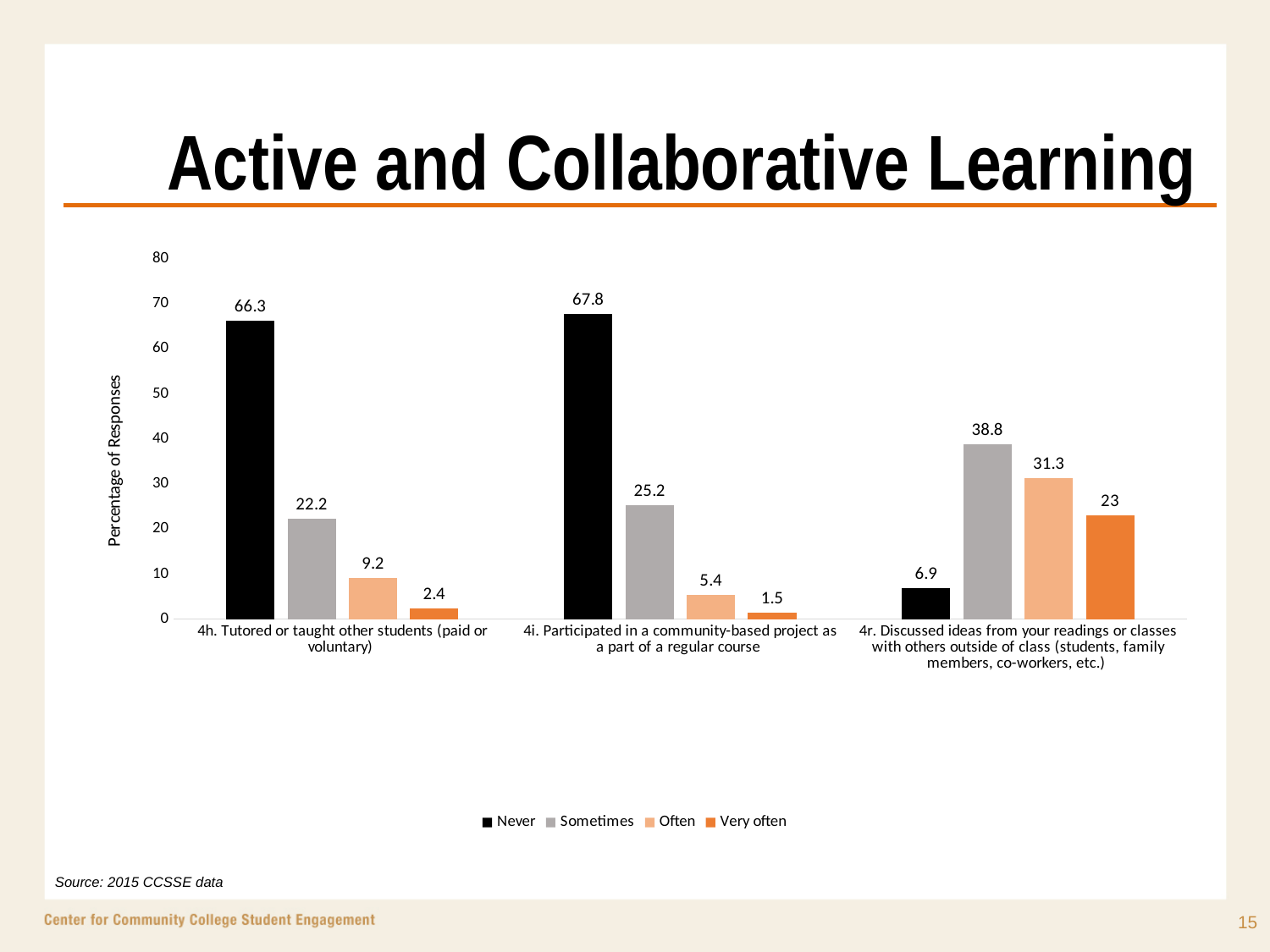
What is the 'Never' value for '4h. Tutored or taught other students (paid or voluntary)'? 66.3 What kind of chart is shown on the slide? bar chart How many question items (category groups) are shown on the x axis? 3 What is the 'Often' value for '4i. Participated in a community-based project as a part of a regular course'? 5.4 What is the difference between the 'Never' values for '4i. Participated in a community-based project' and '4h. Tutored or taught other students'? 1.5 What is the label of the y axis? Percentage of Responses Which is larger: the 'Sometimes' value for '4h. Tutored or taught other students' or the 'Sometimes' value for '4i. Participated in a community-based project'? 4i. Participated in a community-based project Is the 'Sometimes' value for '4r. Discussed ideas from your readings or classes with others outside of class' greater or less than 30? greater Which response category has the highest value for '4r. Discussed ideas from your readings or classes with others outside of class'? Sometimes How many series does the legend list? 4 Which response category has the lowest value for '4i. Participated in a community-based project as a part of a regular course'? Very often What is the 'Very often' value for '4r. Discussed ideas from your readings or classes with others outside of class'? 23